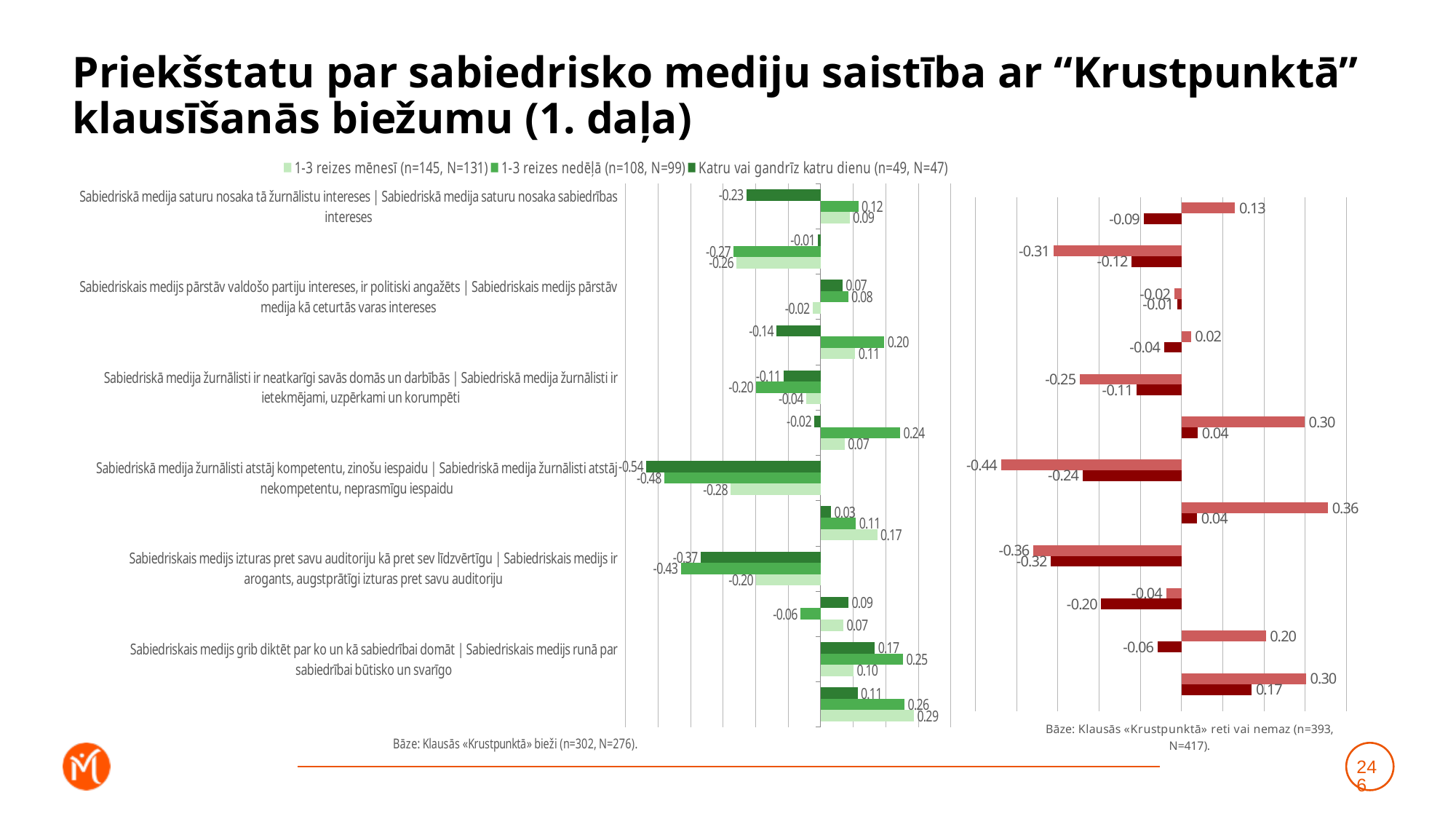
In the left (green) chart, what is the value for '1-3 reizes nedēļā' for the category 'Sabiedriskais medijs grib diktēt par ko un kā sabiedrībai domāt | Sabiedriskais medijs runā par sabiedrībai būtisko un svarīgo'? 0.25 What type of chart is used on this slide? bar chart Which chart has the larger maximum value, the left (green) chart or the right (red) chart? the right (red) chart What is the lowest value shown in the left (green) chart? -0.54 In the left (green) chart, what is the value for 'Katru vai gandrīz katru dienu' for the category 'Sabiedriskā medija saturu nosaka tā žurnālistu intereses | Sabiedriskā medija saturu nosaka sabiedrības intereses'? -0.23 What is the difference between the highest value (0.29) and the lowest value (-0.54) in the left (green) chart? 0.83 What base note is printed under the left (green) chart? Bāze: Klausās «Krustpunktā» bieži (n=302, N=276). In the left (green) chart, what is the value for '1-3 reizes mēnesī' for the category 'Sabiedriskā medija žurnālisti atstāj kompetentu, zinošu iespaidu | Sabiedriskā medija žurnālisti atstāj nekompetentu, neprasmīgu iespaidu'? -0.28 How many series does the legend of the left (green) chart list? 3 What is the highest value shown in the left (green) chart? 0.29 What is the highest value shown in the right (red) chart? 0.36 What is the lowest value shown in the right (red) chart? -0.44